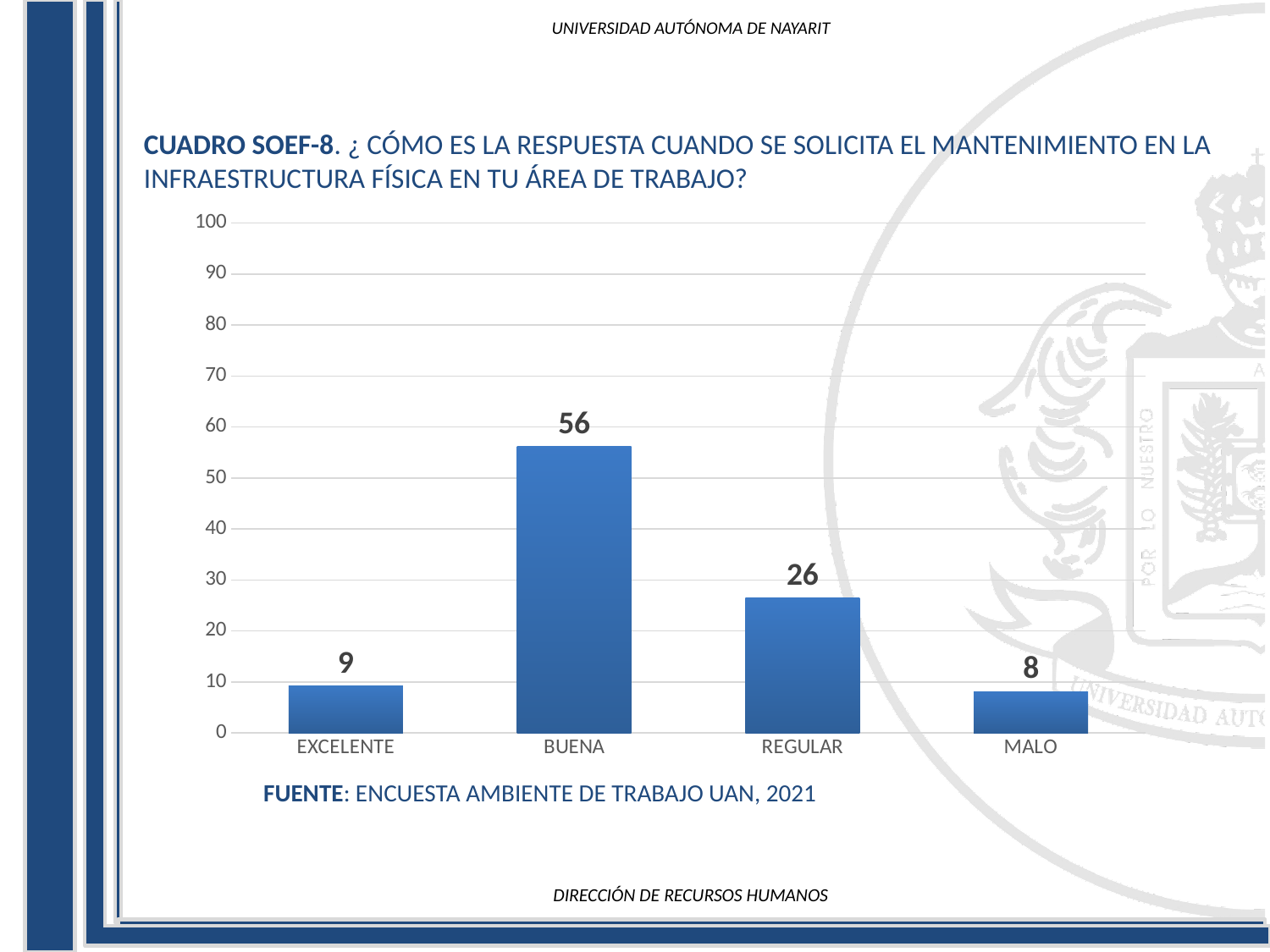
Is the value for BUENA greater or less than 50? greater What is the difference between the values for BUENA and REGULAR? 30 What is the value for EXCELENTE? 9 What is the difference between the values for EXCELENTE and MALO? 1 How many categories are shown on the x axis? 4 What is the value for BUENA? 56 What is the value for REGULAR? 26 Which category has the highest value? BUENA What is the value for MALO? 8 Which is larger, the value for REGULAR or the value for EXCELENTE? REGULAR What kind of chart is shown on the slide? bar chart Which category has the lowest value? MALO